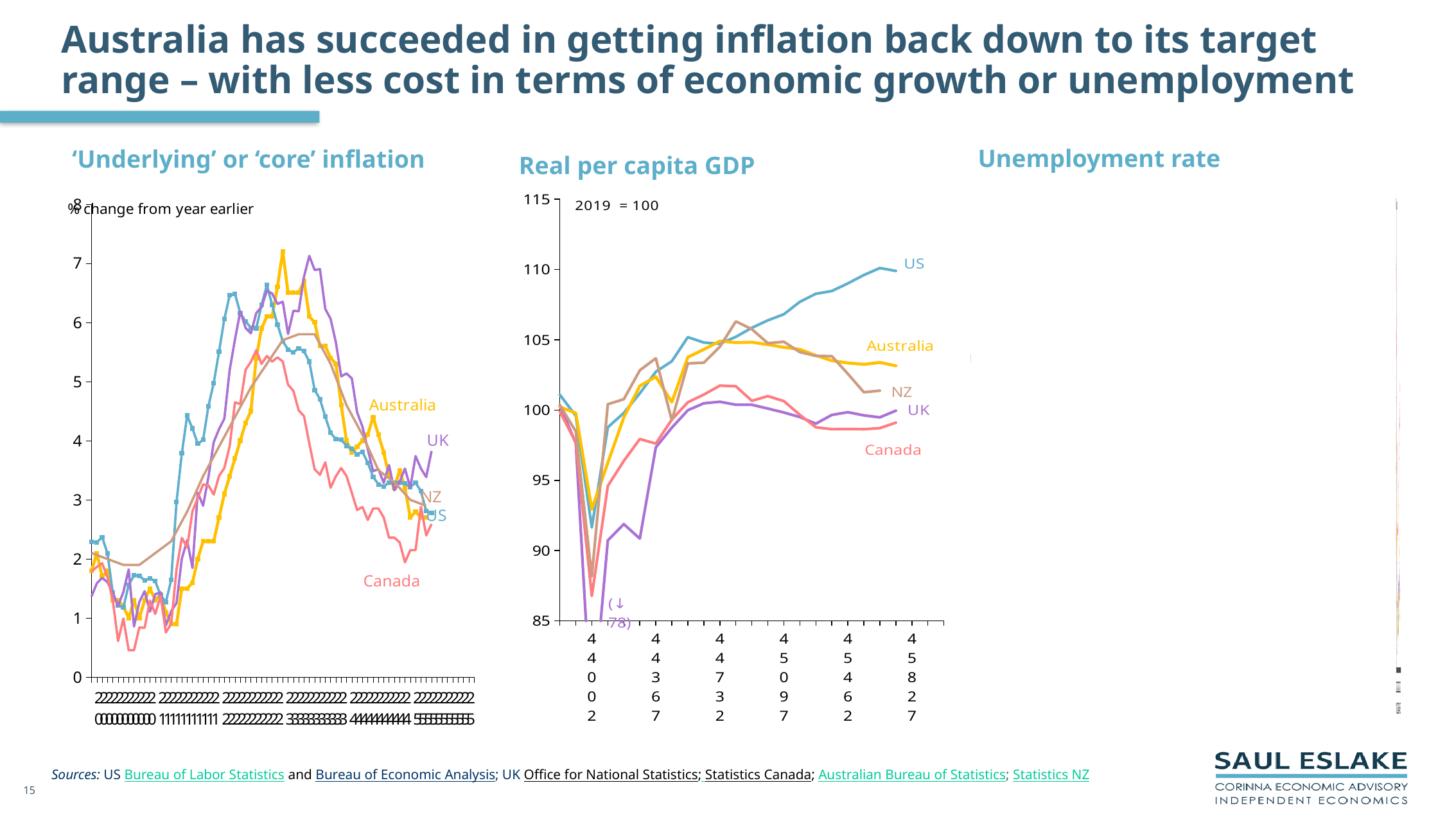
On the Real per capita GDP chart, which base year is the index set to 100? 2019 How many countries are plotted on the Real per capita GDP chart? 5 On the 'Underlying' or 'core' inflation chart, is the peak value for Australia greater or less than 7? greater What kind of chart is the 'Underlying' or 'core' inflation chart? line chart On the Real per capita GDP chart, is the final value for the US greater or less than 105? greater On the 'Underlying' or 'core' inflation chart, is the peak value for Canada greater or less than 6? less On the 'Underlying' or 'core' inflation chart, what unit is shown on the y axis? % change from year earlier On the Real per capita GDP chart, which country has the highest value at the end of the series? US On the 'Underlying' or 'core' inflation chart, at the end of the series, which is higher: the UK or Canada? UK On the Real per capita GDP chart, what value does the annotation say the UK line fell to? 78